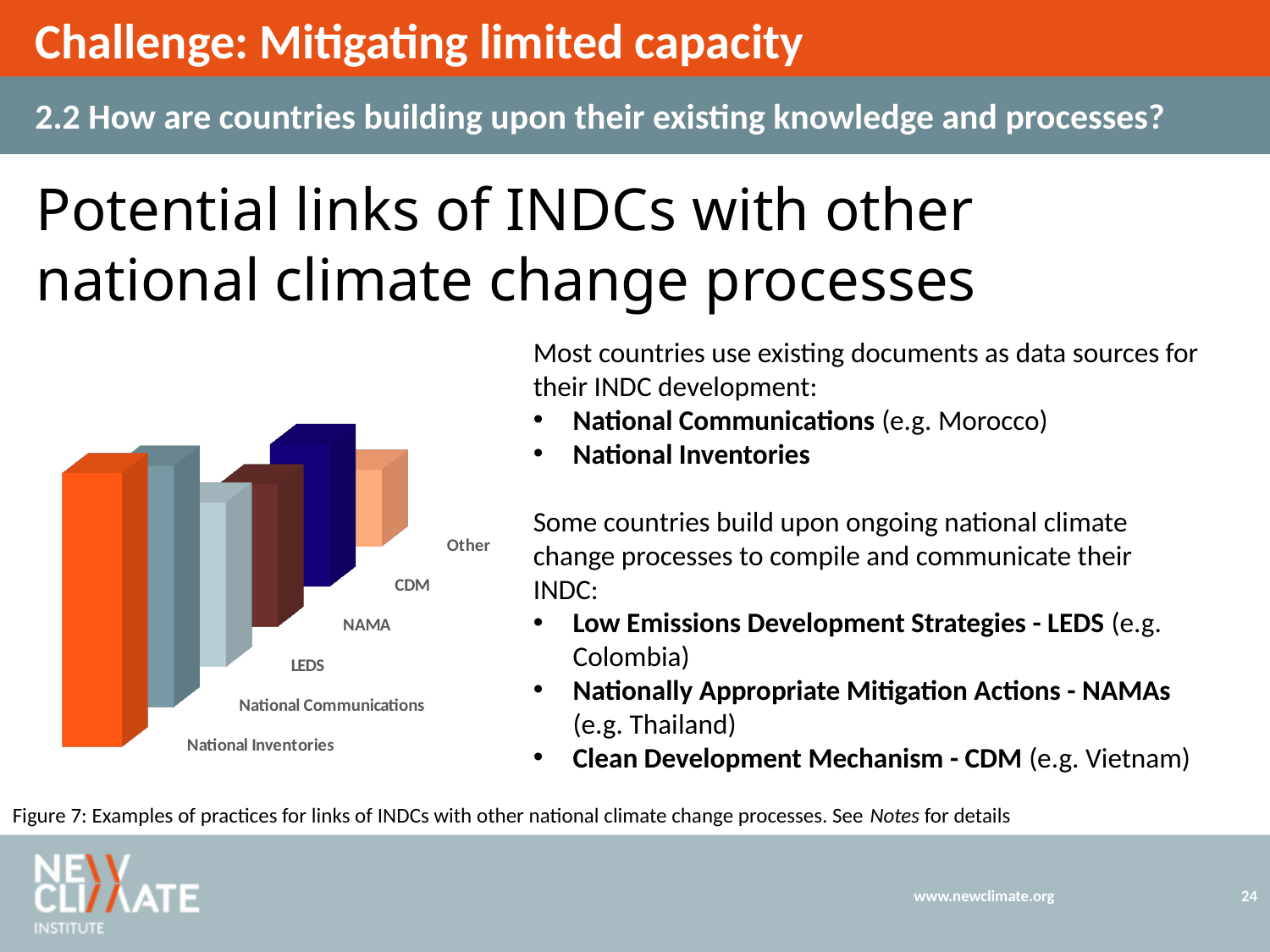
How many categories does the chart show? 6 Which bar is taller, National Inventories or Other? National Inventories What kind of chart is shown on the slide? bar chart Which category is listed first (front-most) along the chart's axis? National Inventories What colour is the National Inventories bar? orange Which category has the shortest bar in the chart? Other Which bar is taller, CDM or Other? CDM Which bar is taller, National Communications or LEDS? National Communications Which category has the tallest bar in the chart? National Inventories